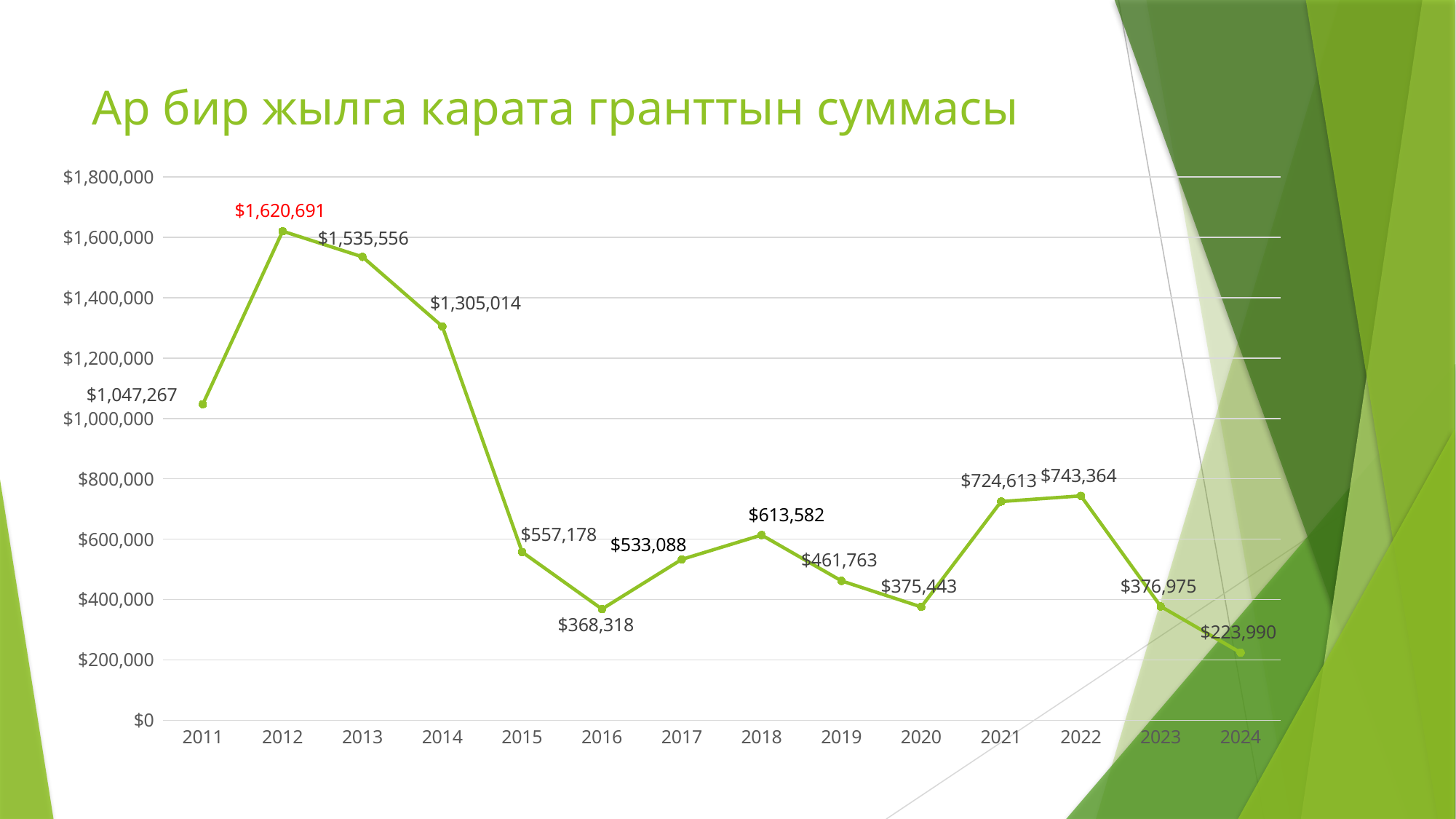
What is the value for 2012? $1,620,691 How many years are plotted on the x axis? 14 What is the difference between the values for 2022 and 2021? $18,751 What is the value for 2016? $368,318 Which year has the highest value? 2012 Do the values rise or fall from 2012 to 2016? fall What is the value for 2024? $223,990 What is the title of the chart? Ар бир жылга карата гранттын суммасы What is the difference between the values for 2012 and 2011? $573,424 Which is larger, the value for 2018 or the value for 2019? 2018 What type of chart is shown on the slide? line chart Which year has the lowest value? 2024